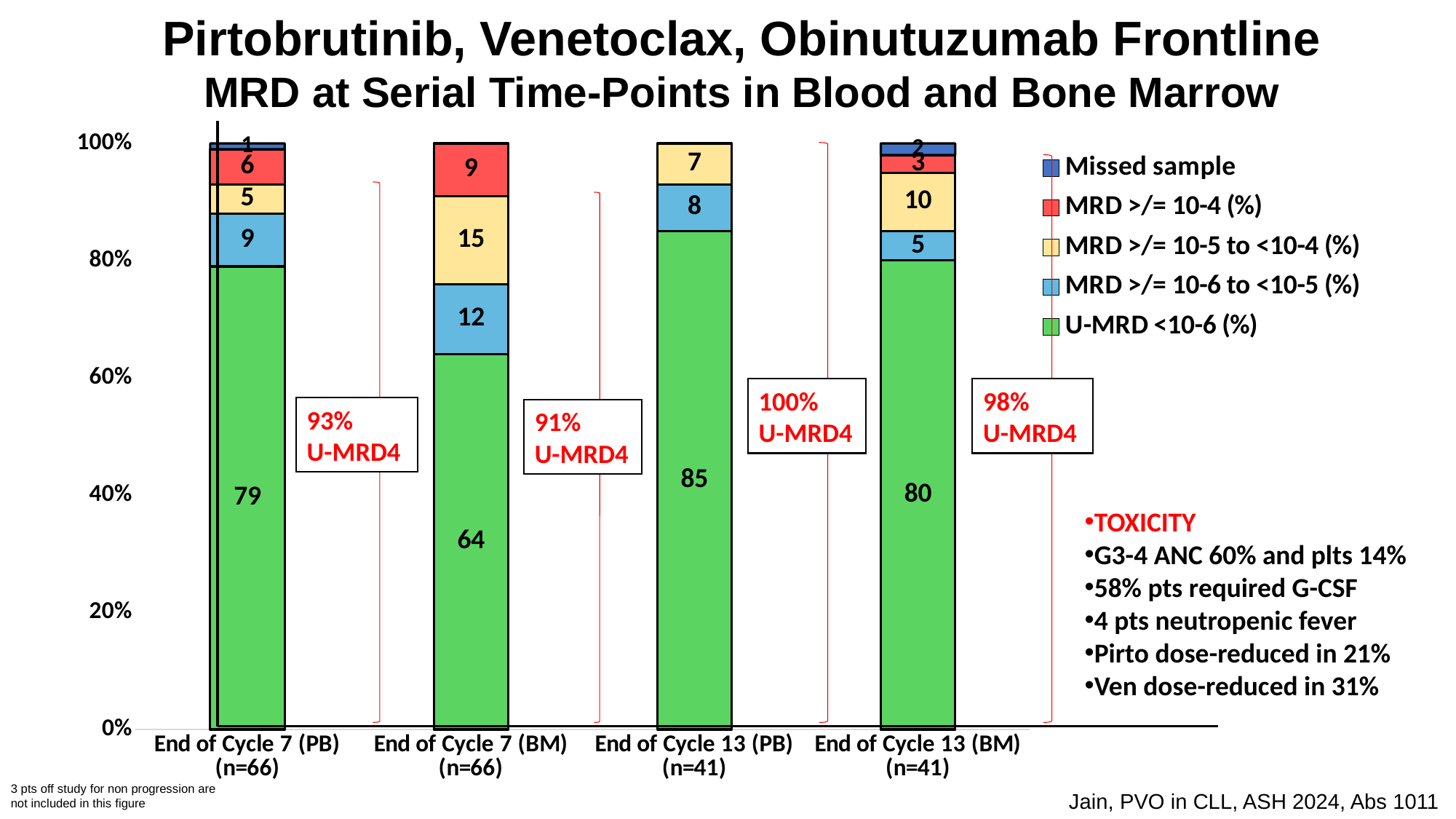
Which time-point has the highest U-MRD <10-6 (%) value? End of Cycle 13 (PB) Which time-point has the lowest U-MRD <10-6 (%) value? End of Cycle 7 (BM) What is the MRD >/= 10-5 to <10-4 (%) value for End of Cycle 13 (BM)? 10 What is the difference in U-MRD <10-6 (%) between End of Cycle 13 (PB) and End of Cycle 7 (BM)? 21 What kind of chart is shown on the slide? Stacked bar chart What is the Missed sample value for End of Cycle 13 (BM)? 2 What is the U-MRD <10-6 (%) value for End of Cycle 7 (BM)? 64 How many series does the legend list? 5 Is the MRD >/= 10-6 to <10-5 (%) value larger for End of Cycle 7 (BM) or End of Cycle 13 (BM)? End of Cycle 7 (BM) How many time-point categories are shown on the x axis? 4 What is the MRD >/= 10-4 (%) value for End of Cycle 7 (PB)? 6 What U-MRD4 percentage is annotated next to the End of Cycle 13 (PB) bar? 100%